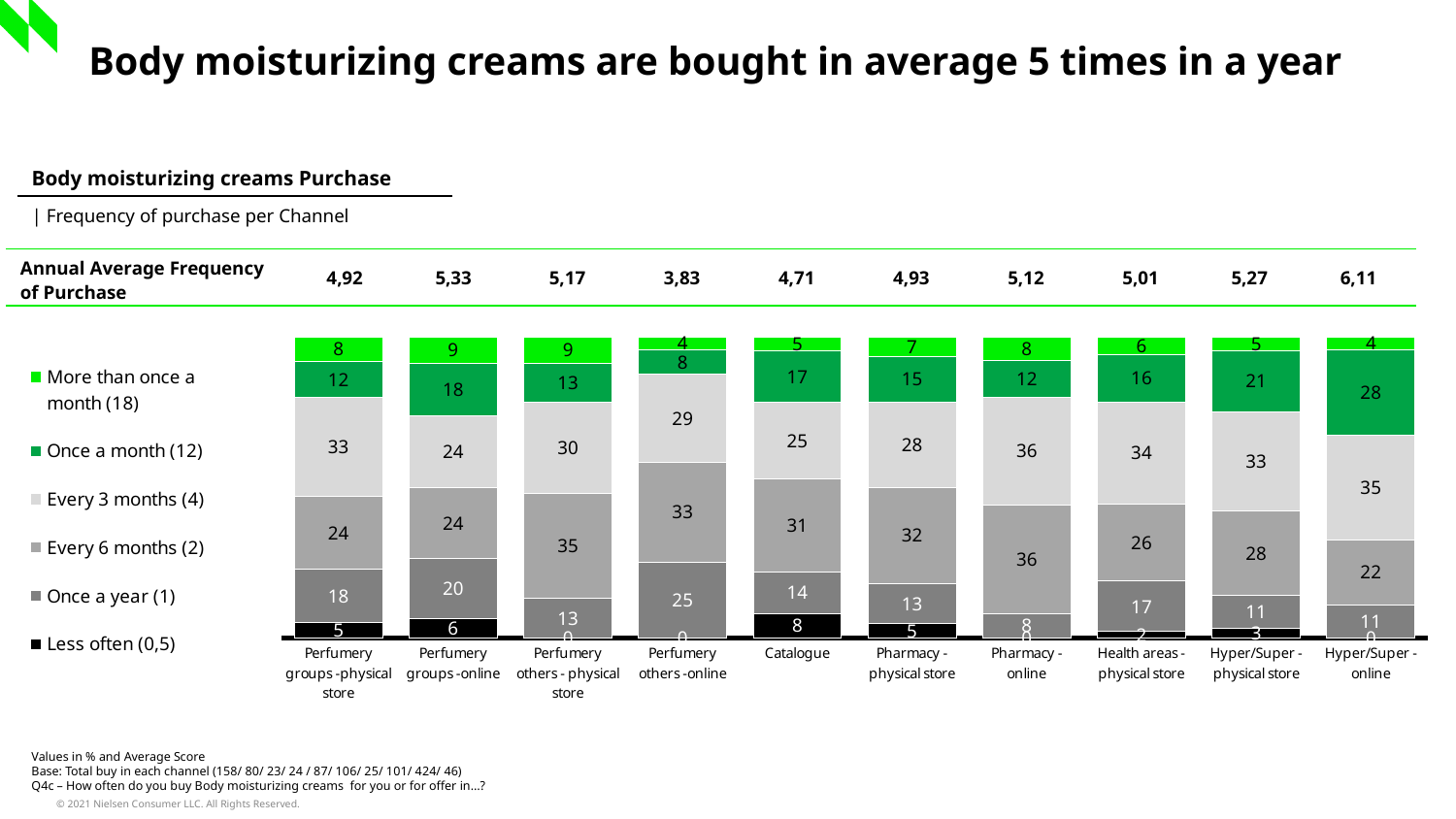
What is the Annual Average Frequency of Purchase shown for Hyper/Super - online? 6,11 What is the value for "Every 6 months (2)" for Perfumery others - physical store? 35 What type of chart is shown on the slide? Stacked bar chart Which channel has the lowest value for "Every 3 months (4)"? Perfumery groups - online What is the value for "Every 3 months (4)" for Pharmacy - online? 36 How many series does the legend list? 6 Which channel has the highest value for "Once a month (12)"? Hyper/Super - online How many channels (categories) are shown along the x axis of the chart? 10 What is the value for "Once a year (1)" for Perfumery others - online? 25 What is the value for "Once a month (12)" for Hyper/Super - online? 28 Which is larger: the "More than once a month (18)" value for Perfumery groups - online or for Catalogue? Perfumery groups - online What is the difference between the "Every 3 months (4)" values for Pharmacy - online and Catalogue? 11